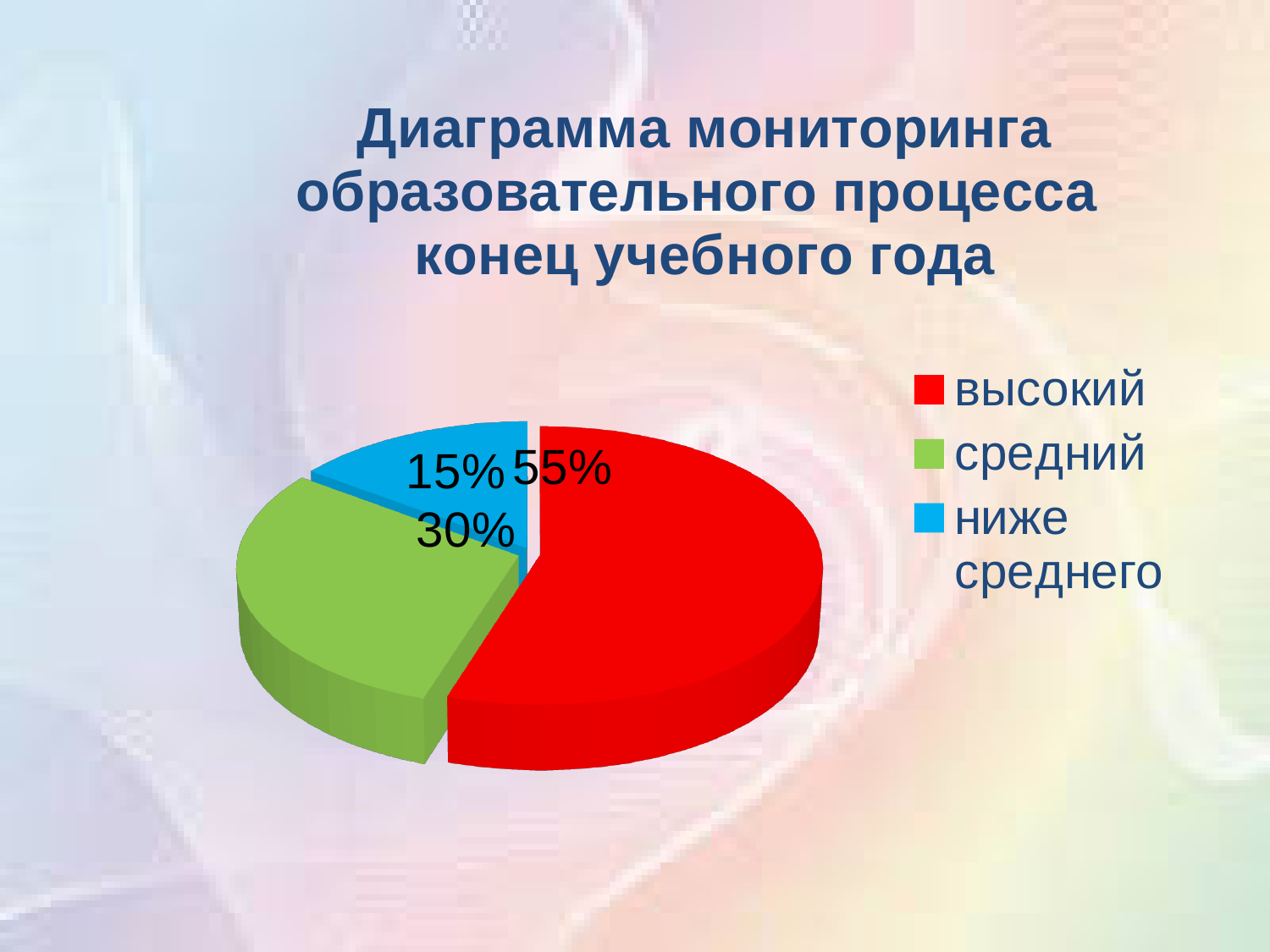
What is the difference between the "высокий" and "средний" shares? 25% Which is larger, the "средний" share or the "ниже среднего" share? средний What kind of chart is shown on the slide? pie chart What percentage does the "средний" slice show? 30% How many categories does the legend list? 3 What percentage does the "ниже среднего" slice show? 15% What percentage does the "высокий" slice show? 55% What is the title of the chart? Диаграмма мониторинга образовательного процесса конец учебного года Which category has the largest share of the pie? высокий What colour is the "высокий" slice? red Which category has the smallest share of the pie? ниже среднего What is the difference between the "средний" and "ниже среднего" shares? 15%